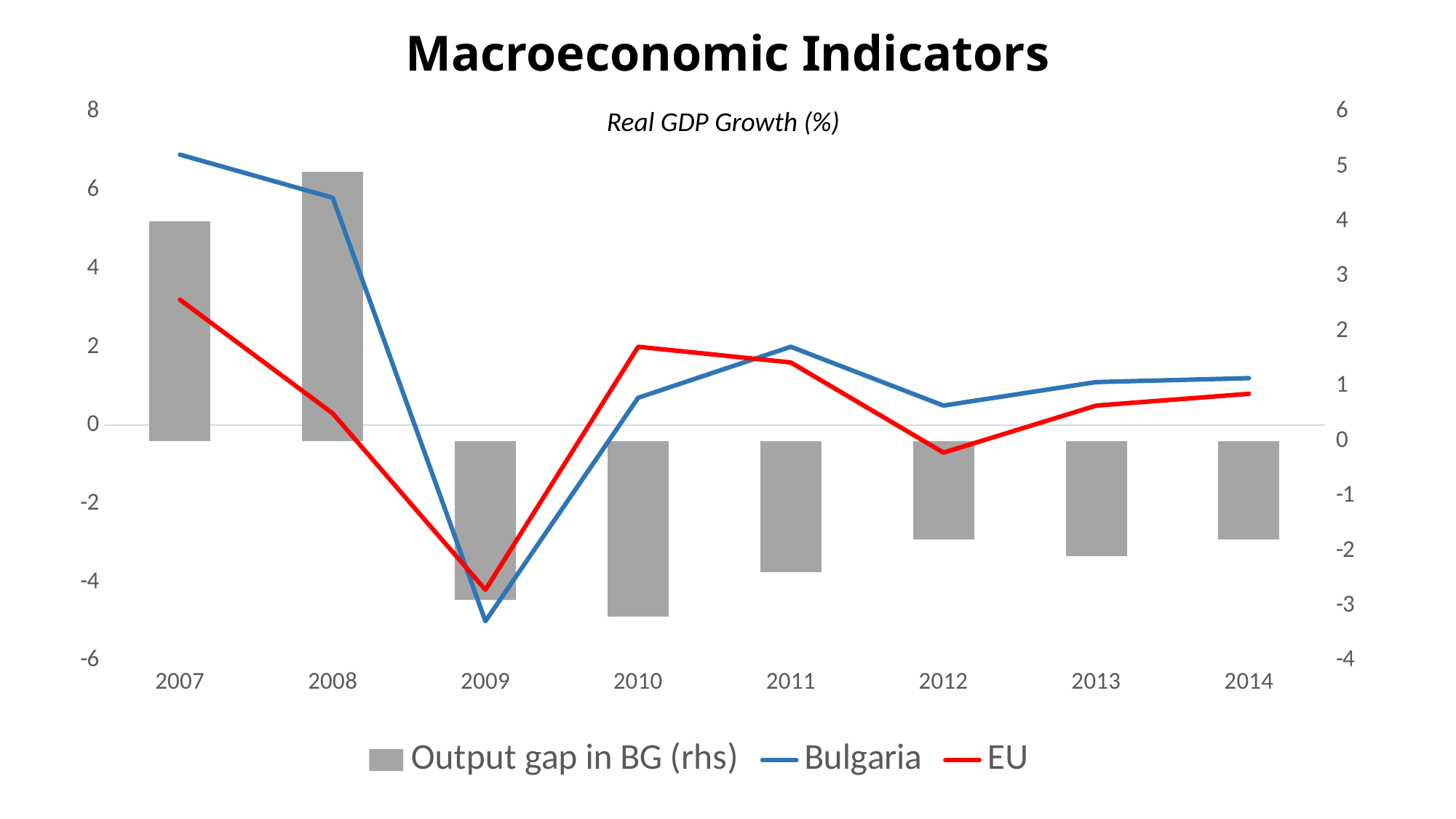
How many years are shown on the x axis? 8 In which year is Bulgaria's real GDP growth highest? 2007 In which year is the EU's real GDP growth lowest? 2009 Does Bulgaria's real GDP growth rise or fall from 2007 to 2009? fall What kind of chart is shown on the slide? A combined bar and line chart In which year is the Output gap in BG bar the tallest (highest value)? 2008 In which year is Bulgaria's real GDP growth lowest? 2009 In 2010, which is larger: real GDP growth for Bulgaria or for the EU? EU How many series does the legend list? 3 Is Bulgaria's real GDP growth in 2009 greater or less than -4? less In 2007, which is larger: real GDP growth for Bulgaria or for the EU? Bulgaria Is Bulgaria's real GDP growth in 2007 greater or less than 6? greater